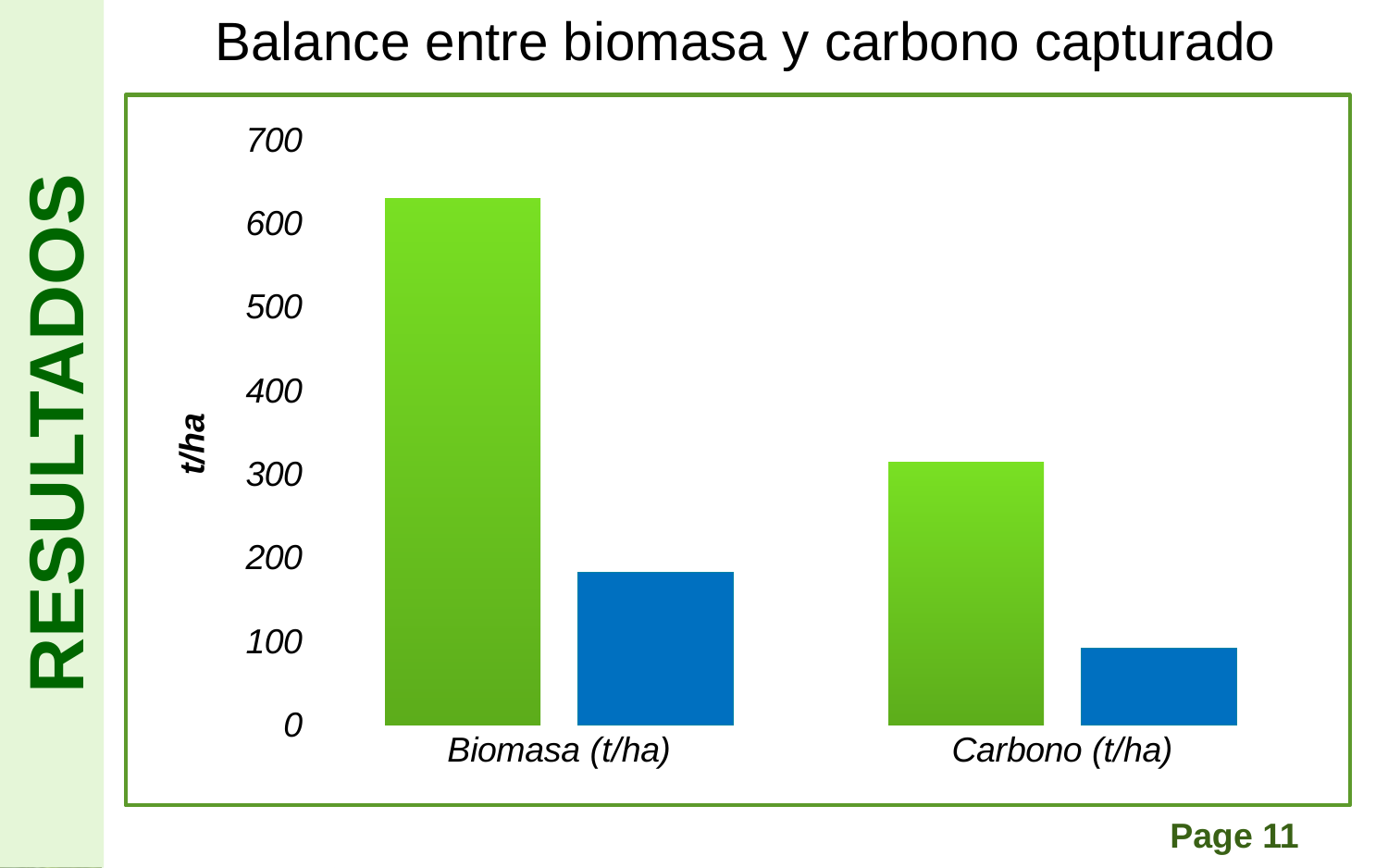
How many categories are shown on the x axis of the chart? 2 Which is larger: the green bar for Carbono (t/ha) or the blue bar for Biomasa (t/ha)? the green bar for Carbono (t/ha) Which category has the tallest bar in the chart? Biomasa (t/ha) Is the value of the green bar for Carbono (t/ha) greater or less than 300? greater What kind of chart is shown on the slide? bar chart What is the label of the vertical axis of the chart? t/ha What is the title of the chart on the slide? Balance entre biomasa y carbono capturado Which category has the shortest bar in the chart? Carbono (t/ha) Do the green bars rise or fall from Biomasa (t/ha) to Carbono (t/ha)? fall Is the value of the blue bar for Biomasa (t/ha) greater or less than 200? less Is the value of the green bar for Biomasa (t/ha) greater or less than 600? greater